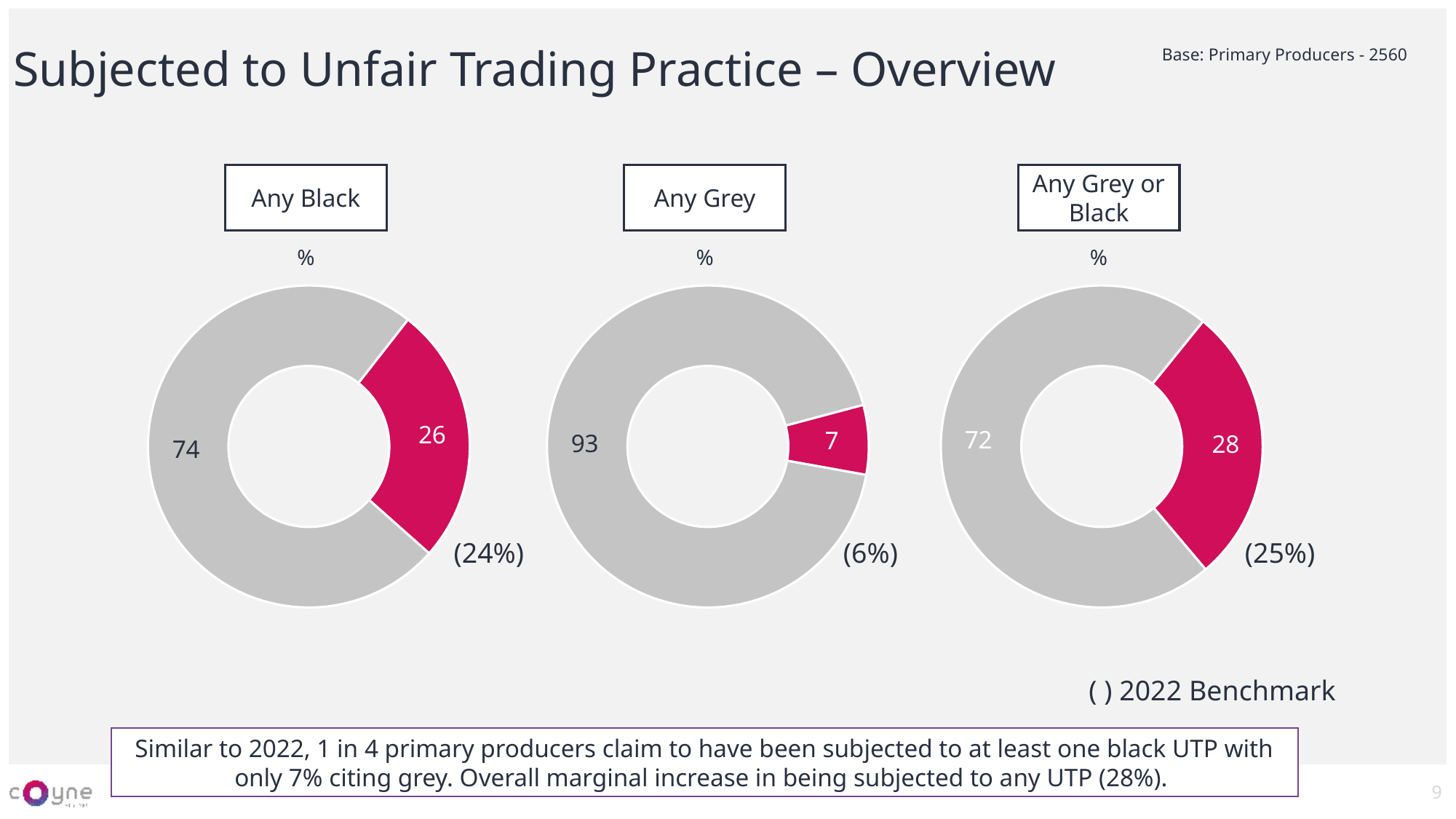
What kind of chart is used for 'Any Black', 'Any Grey' and 'Any Grey or Black'? Doughnut (pie) chart In the 'Any Grey' chart, what value is shown for the grey segment? 93 How many segments does each doughnut chart have? 2 In the 'Any Grey or Black' chart, which segment is larger, the grey one or the pink one? The grey one (72) Across the three charts, which has the largest pink (highlighted) segment? Any Grey or Black In the 'Any Black' chart, what is the difference between the grey segment and the pink segment? 48 How many doughnut charts are shown on the slide? 3 In the 'Any Grey' chart, what is the 2022 benchmark figure shown in parentheses? (6%) In the 'Any Black' chart, what value is shown for the pink (highlighted) segment? 26 Across the three charts, which has the smallest pink (highlighted) segment? Any Grey In the 'Any Black' chart, what is the 2022 benchmark figure shown in parentheses? (24%) In the 'Any Grey or Black' chart, what value is shown for the pink (highlighted) segment? 28